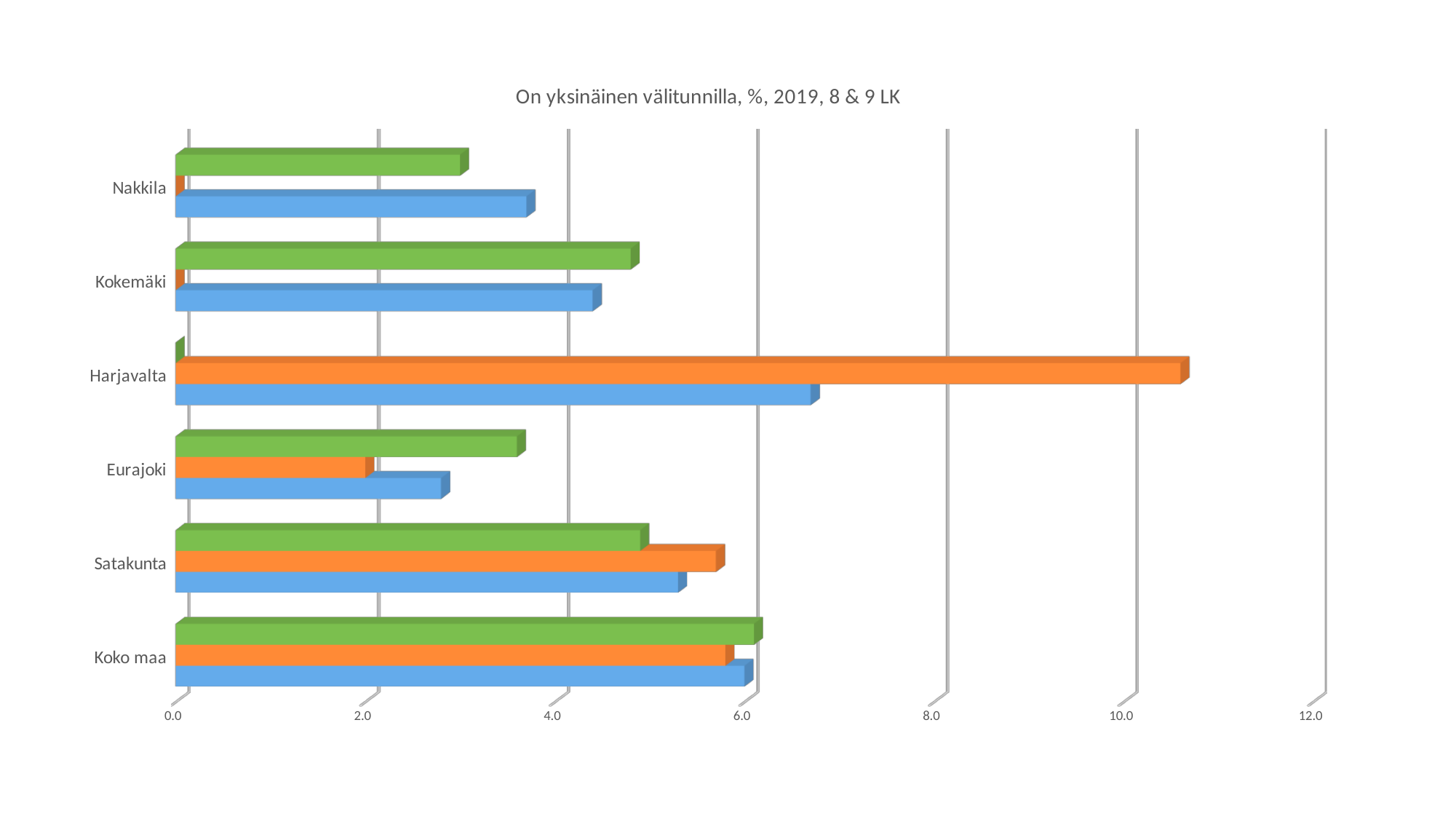
Is the value of the orange bar for Harjavalta greater or less than 10.0? greater Which category has the longest orange bar? Harjavalta For Harjavalta, which bar is longer, the orange bar or the blue bar? orange Is the value of the orange bar for Satakunta greater or less than 6.0? less Which category has the shortest green bar? Harjavalta Is the value of the green bar for Kokemäki greater or less than 4.0? greater What kind of chart is shown on the slide? bar chart What is the title of the chart? On yksinäinen välitunnilla, %, 2019, 8 & 9 LK For Nakkila, which bar is longer, the green bar or the blue bar? blue How many categories are shown on the vertical axis of the chart? 6